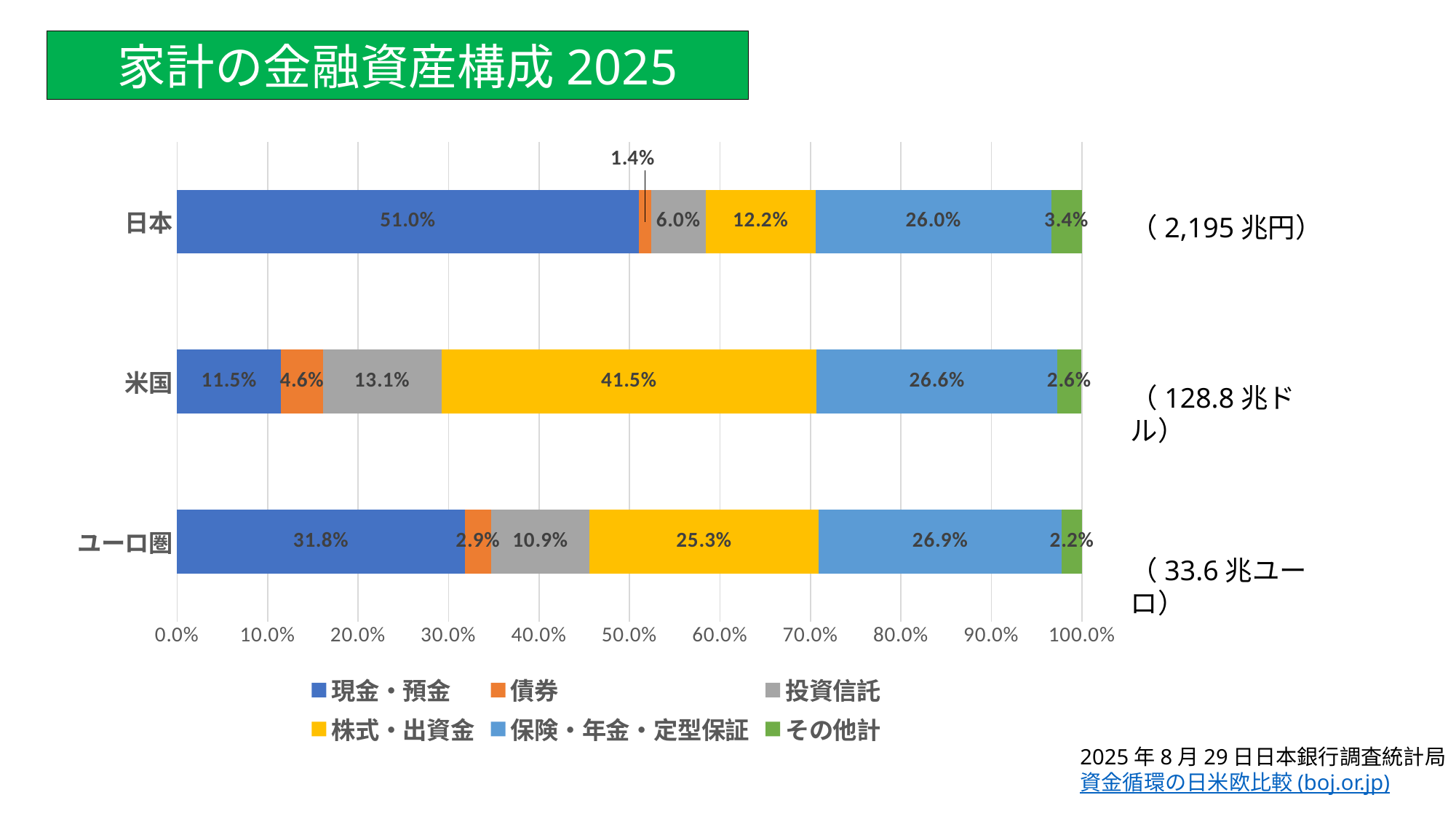
What is the difference between the 株式・出資金 values for 米国 and ユーロ圏? 16.2% Which is larger, the 投資信託 value for 米国 or for ユーロ圏? 米国 How many categories are shown on the chart? 3 How many series does the legend list? 6 What is the value for 保険・年金・定型保証 in the ユーロ圏 bar? 26.9% What is the value for 現金・預金 in the 日本 bar? 51.0% What kind of chart is shown on the slide? Stacked bar chart What is the value for 債券 in the 日本 bar? 1.4% Which category has the lowest value for 債券? 日本 Which category has the highest value for 現金・預金? 日本 What is the value for 株式・出資金 in the 米国 bar? 41.5% What is the difference between the 現金・預金 values for 日本 and 米国? 39.5%